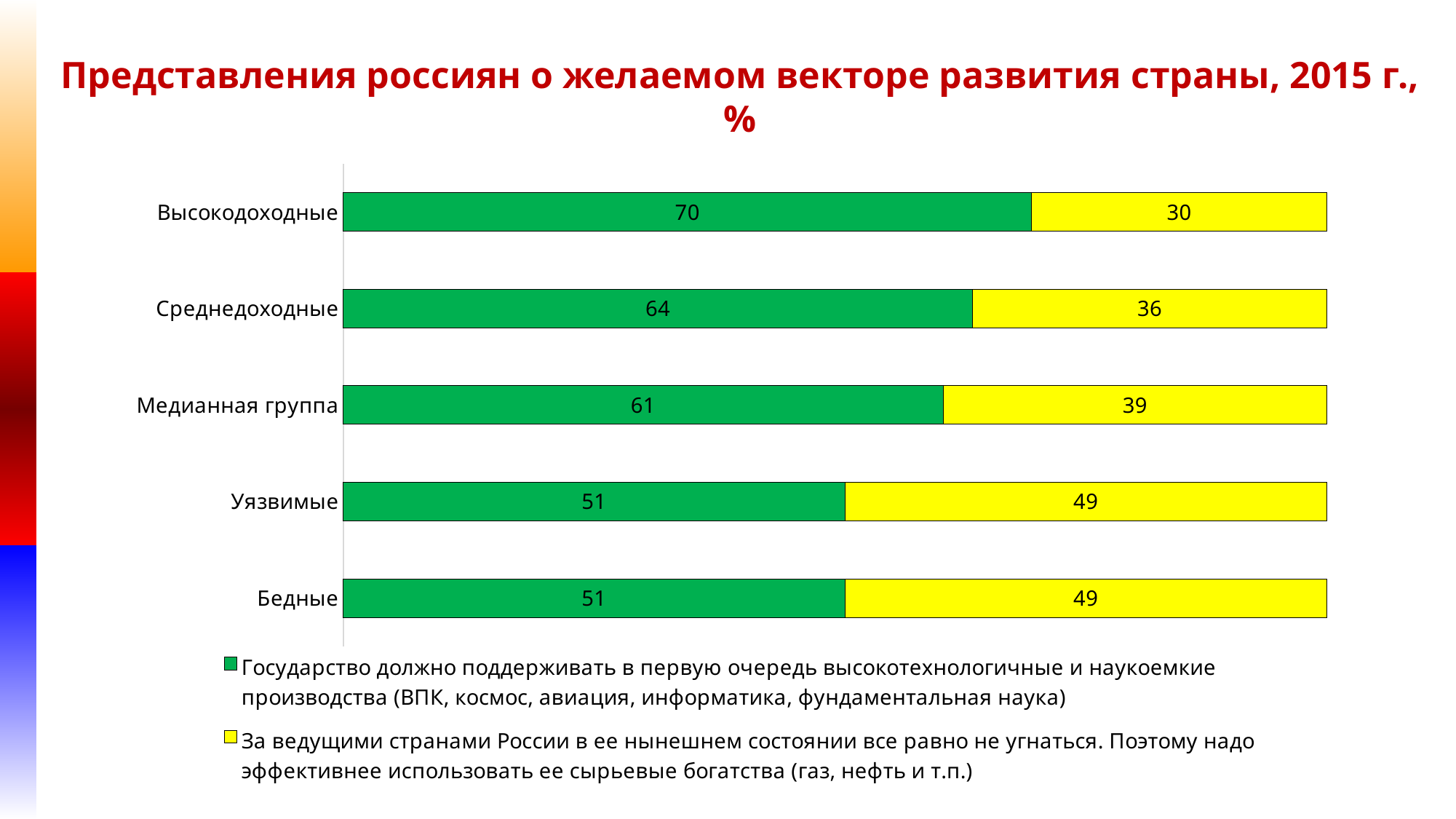
What kind of chart is shown on the slide? Stacked bar chart Which category has the lowest value for the yellow series (use raw material wealth)? Высокодоходные Which category has the highest value for the green series (state should support high-tech industries)? Высокодоходные What is the difference between the green and yellow values for Уязвимые? 2 What is the value of the yellow series (use raw material wealth) for Среднедоходные? 36 What is the value of the green series (state should support high-tech industries) for Высокодоходные? 70 What is the value of the green series for Медианная группа? 61 Which is larger: the yellow value for Медианная группа or the yellow value for Среднедоходные? Медианная группа How many series does the legend list? 2 How many categories are shown on the chart? 5 What is the total of the stacked bar for Бедные? 100 What is the difference between the green values for Высокодоходные and Бедные? 19